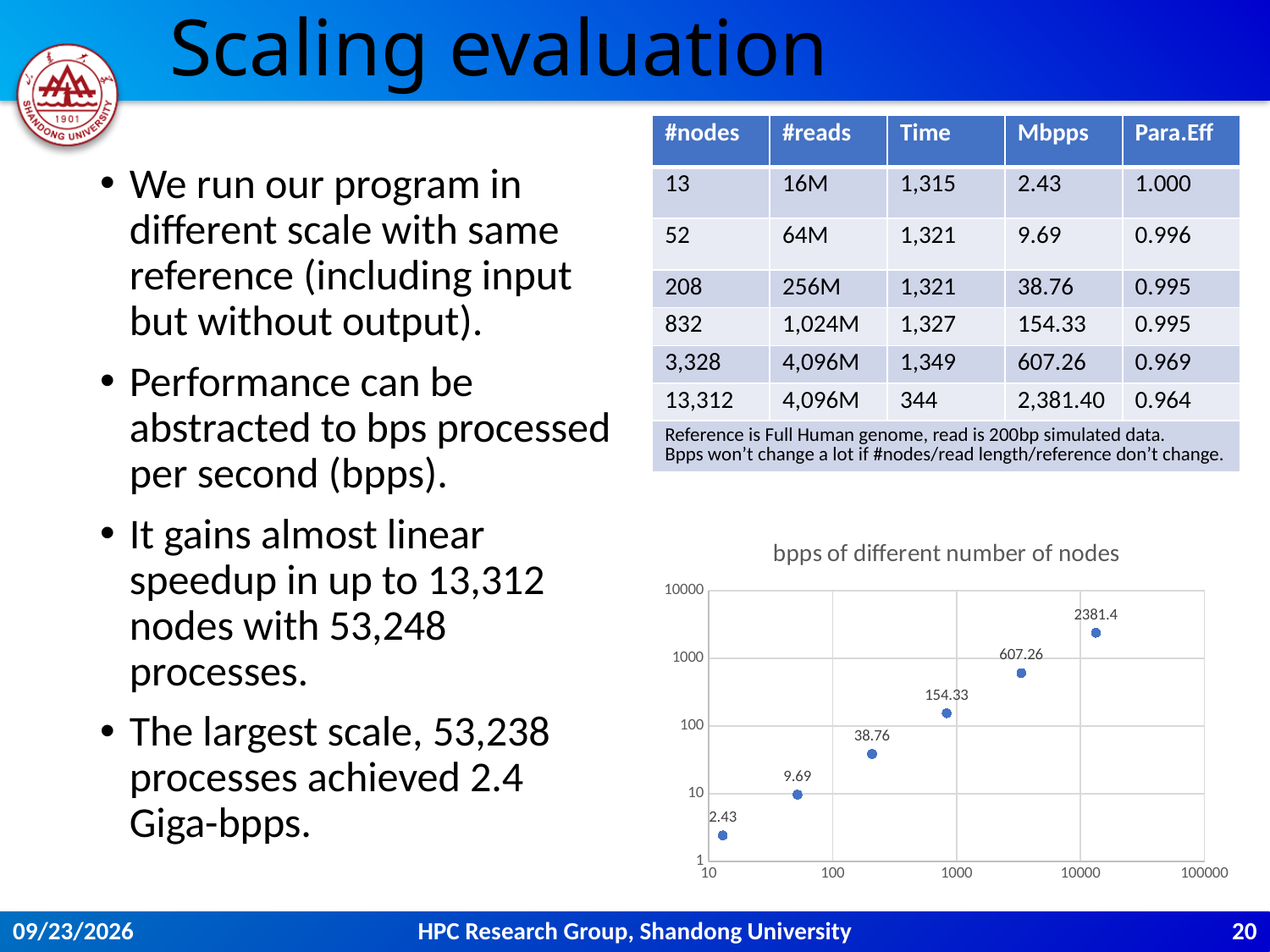
What is the title of the chart? bpps of different number of nodes Is the value of the fourth point from the left greater or less than 100? greater Which is larger, the point labelled 607.26 or the point labelled 154.33? 607.26 Do the plotted values rise or fall as the number of nodes increases along the x axis? rise What is the data label of the fourth point from the left in the chart? 154.33 What kind of chart is shown on the slide? scatter chart What is the difference between the highest point (2381.4) and the second highest point (607.26)? 1774.14 What is the value of the lowest point in the chart? 2.43 What is the data label of the second point from the left in the chart? 9.69 How many data points are plotted in the chart? 6 What is the data label of the third point from the left in the chart? 38.76 What is the value of the highest point in the chart? 2381.4